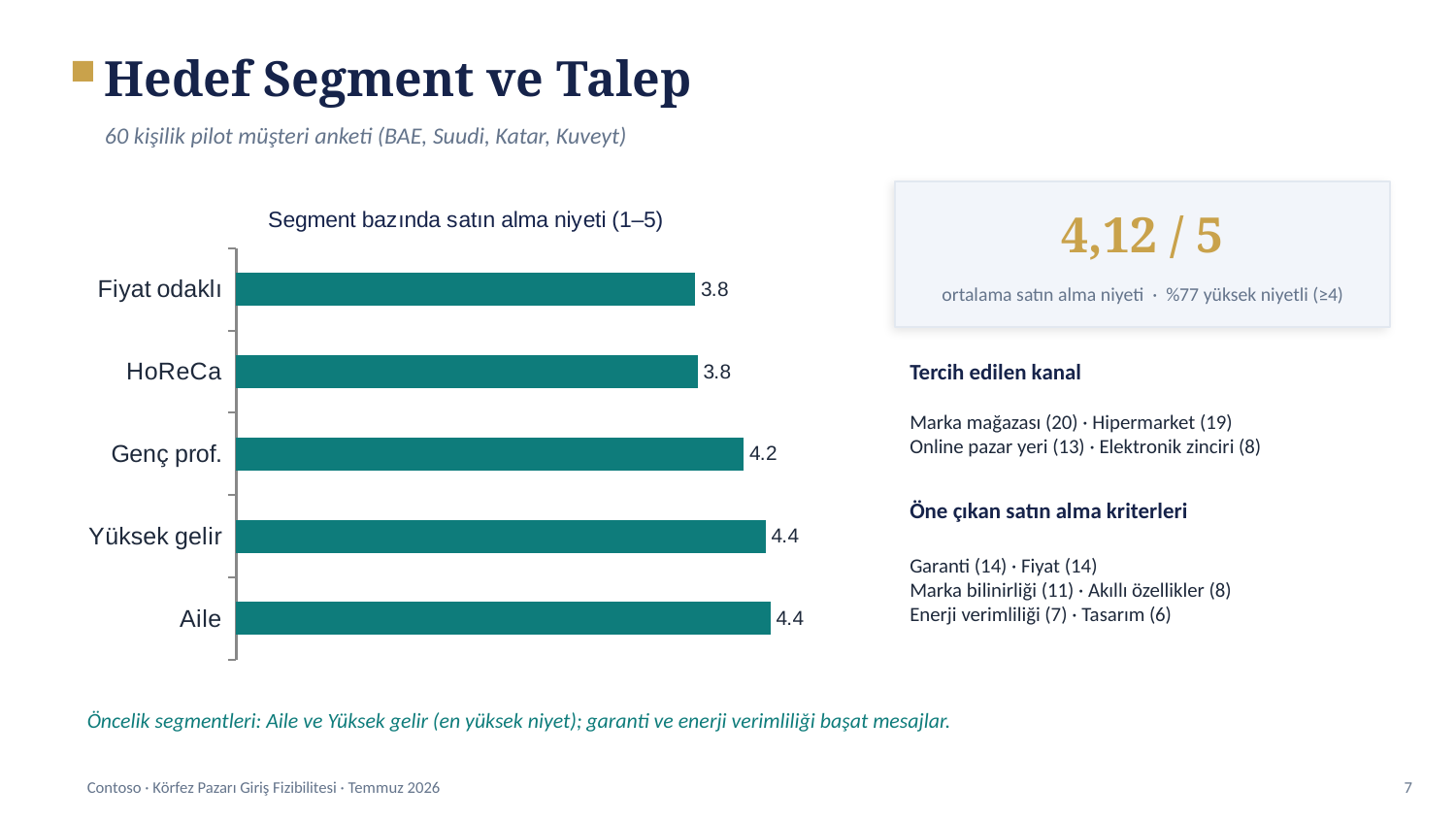
Which has a higher purchase intent value, Yüksek gelir or Fiyat odaklı? Yüksek gelir What is the difference between the values for Genç prof. and HoReCa? 0.4 What is the title of the chart? Segment bazında satın alma niyeti (1–5) How many segments are shown in the chart? 5 What is the purchase intent value for HoReCa? 3.8 Which has a higher purchase intent value, Genç prof. or HoReCa? Genç prof. What is the difference between the values for Aile and Fiyat odaklı? 0.6 What is the purchase intent value for Yüksek gelir? 4.4 What kind of chart is shown on the slide? Bar chart What is the purchase intent value for Aile? 4.4 What is the purchase intent value for Genç prof.? 4.2 What is the purchase intent value for Fiyat odaklı? 3.8